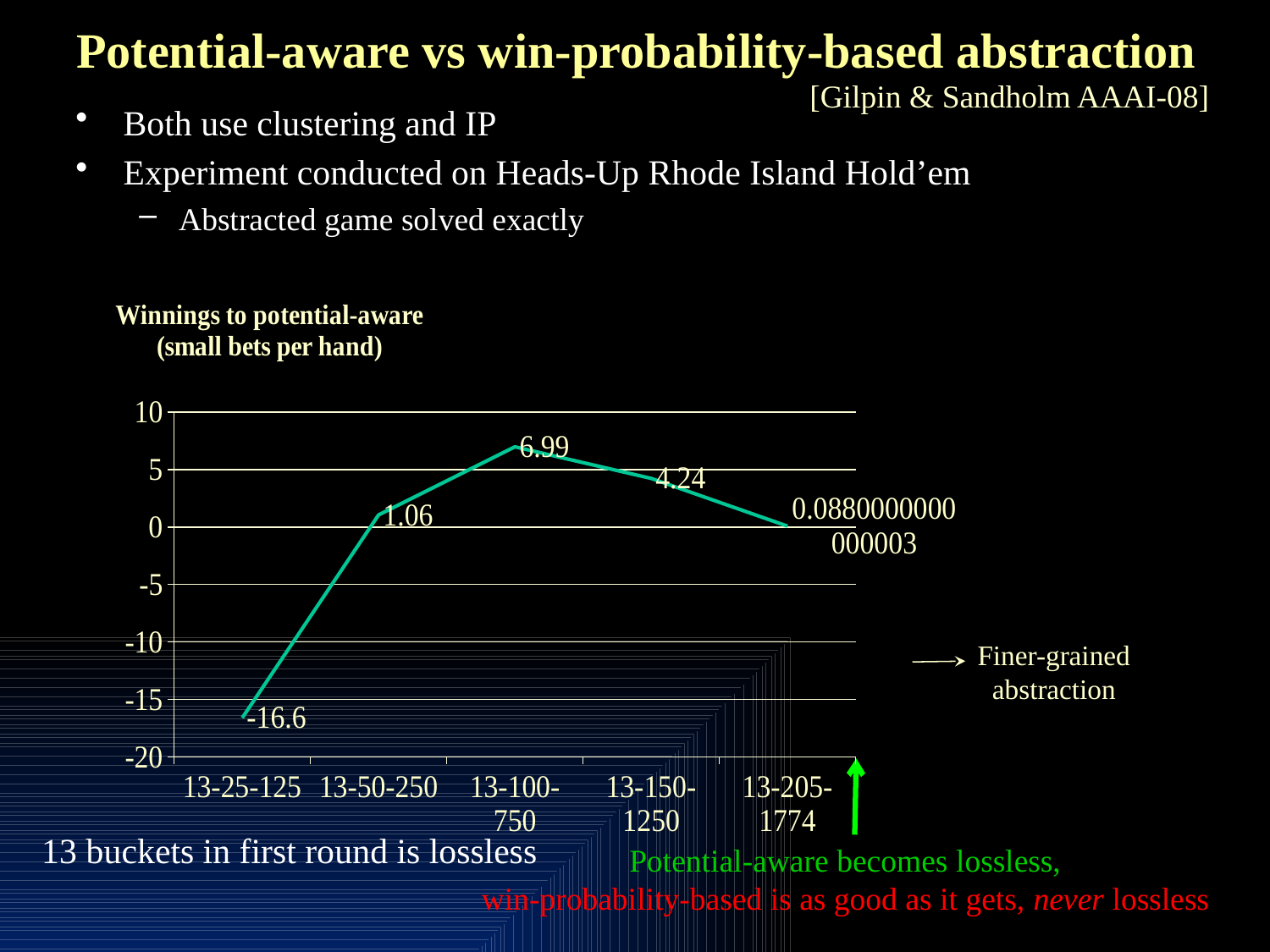
What kind of chart is shown on the slide? line chart How many abstractions are plotted on the x axis? 5 What is the value for 13-50-250? 1.06 What is the value for 13-100-750? 6.99 Is the value for 13-205-1774 greater or less than 5? less What is the value for 13-25-125? -16.6 What is the difference between the values for 13-100-750 and 13-150-1250? 2.75 Which abstraction has the highest winnings to potential-aware? 13-100-750 What is the difference between the values for 13-50-250 and 13-25-125? 17.66 Which is larger, the value for 13-50-250 or the value for 13-150-1250? 13-150-1250 Which abstraction has the lowest winnings to potential-aware? 13-25-125 What is the value for 13-150-1250? 4.24